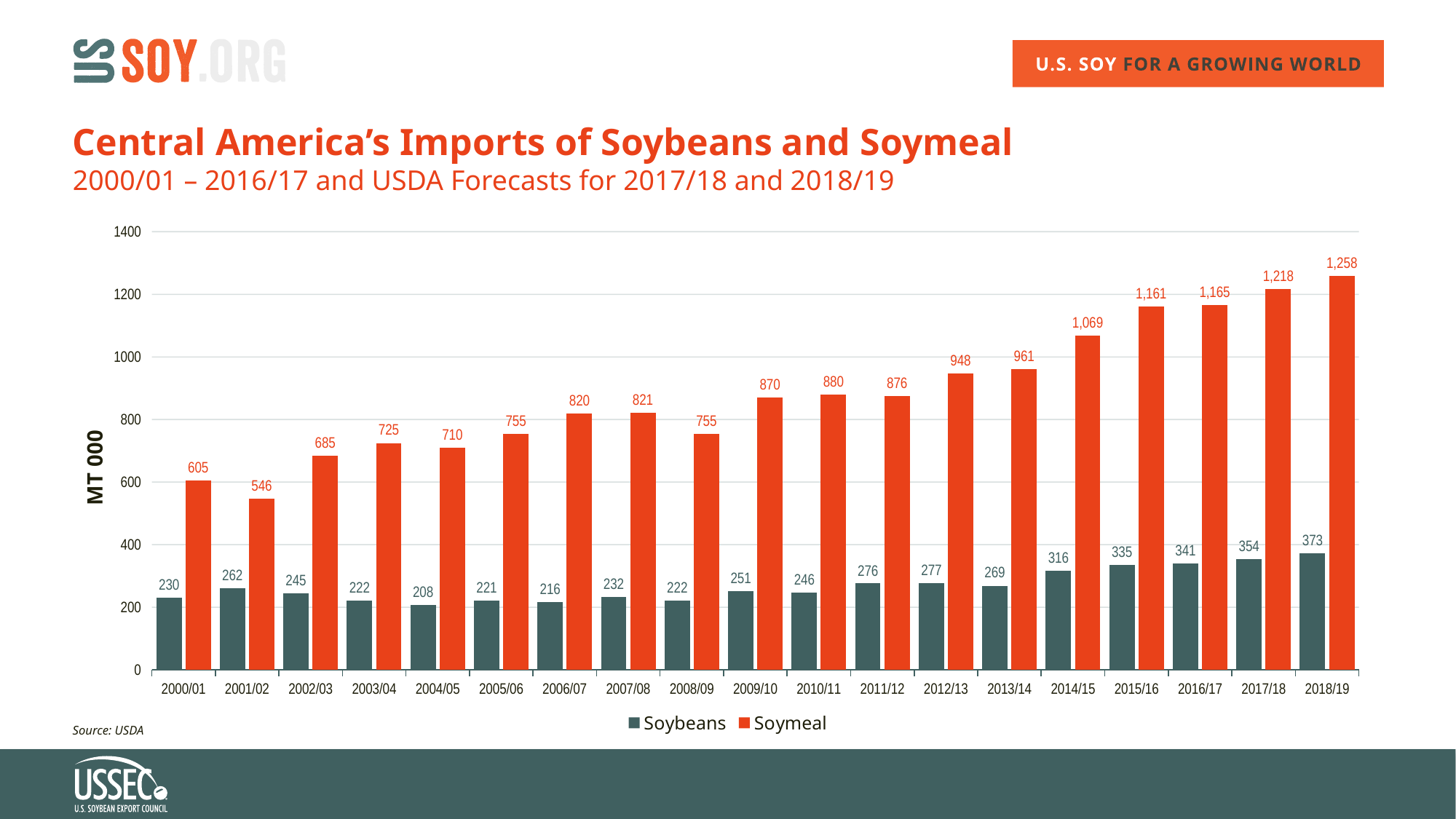
What is the label on the vertical axis? MT 000 What kind of chart is shown on the slide? Bar chart Which year has the lowest Soybeans value? 2004/05 Is the Soymeal value for 2014/15 greater or less than 1000? greater What is the Soybeans import value for 2004/05? 208 What is the difference between the Soymeal and Soybeans values in 2000/01? 375 Do the Soymeal values generally rise or fall from 2008/09 to 2018/19? Rise How many years are shown on the x axis? 19 Which is larger, the Soymeal value for 2001/02 or the Soymeal value for 2002/03? 2002/03 Which year has the highest Soymeal value? 2018/19 What is the Soymeal import value for 2018/19? 1,258 How many series does the legend list? 2